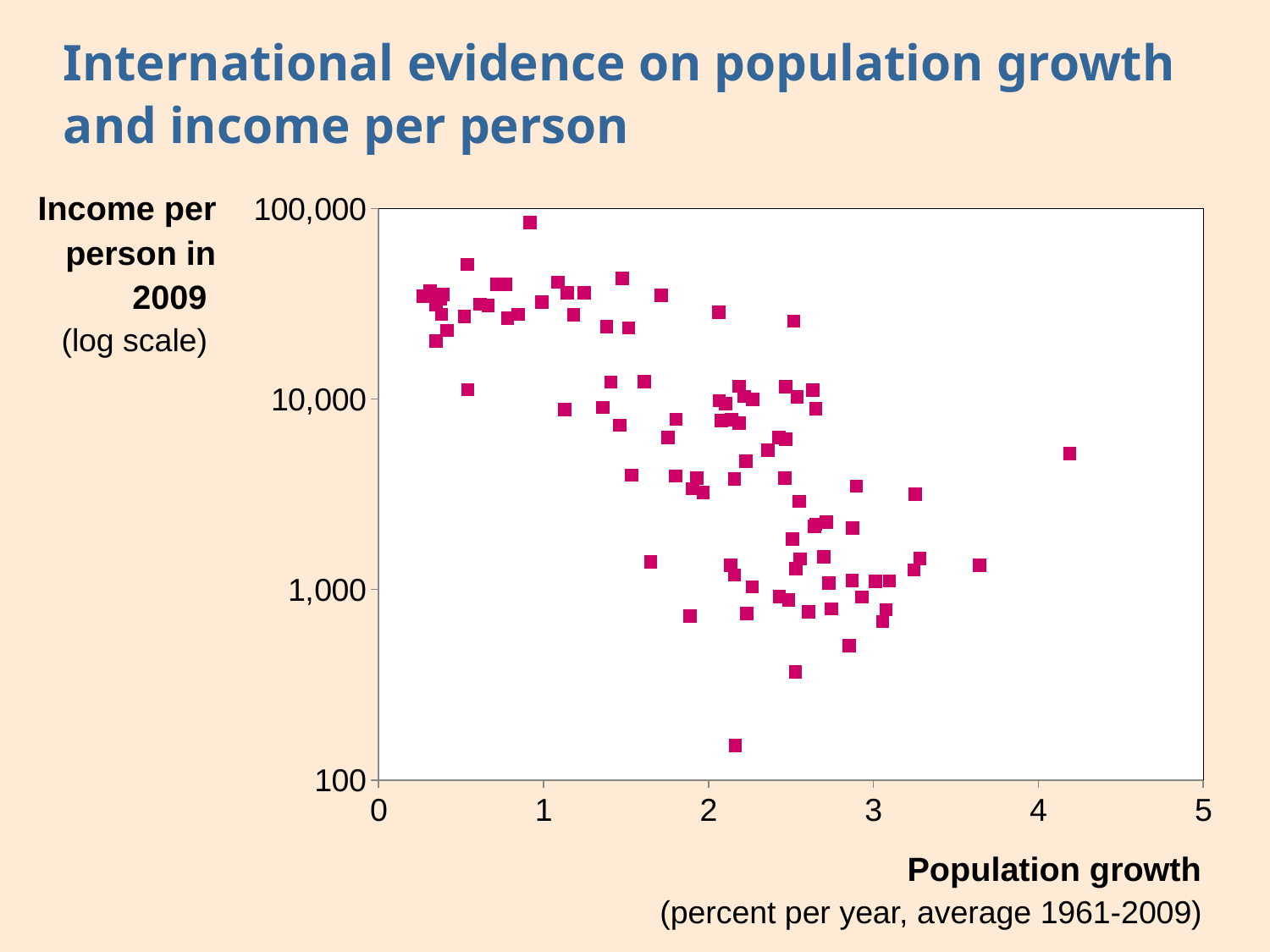
Is the largest population growth value plotted greater or less than 3? greater Is the lowest income per person plotted greater or less than 1,000? less What is the title of the chart on the slide? International evidence on population growth and income per person Is the income per person of the point with the smallest population growth greater or less than 10,000? greater What kind of chart is shown on the slide? scatter plot What is the label of the x axis? Population growth (percent per year, average 1961-2009) As population growth increases along the x axis, do the plotted income per person values generally rise or fall? fall